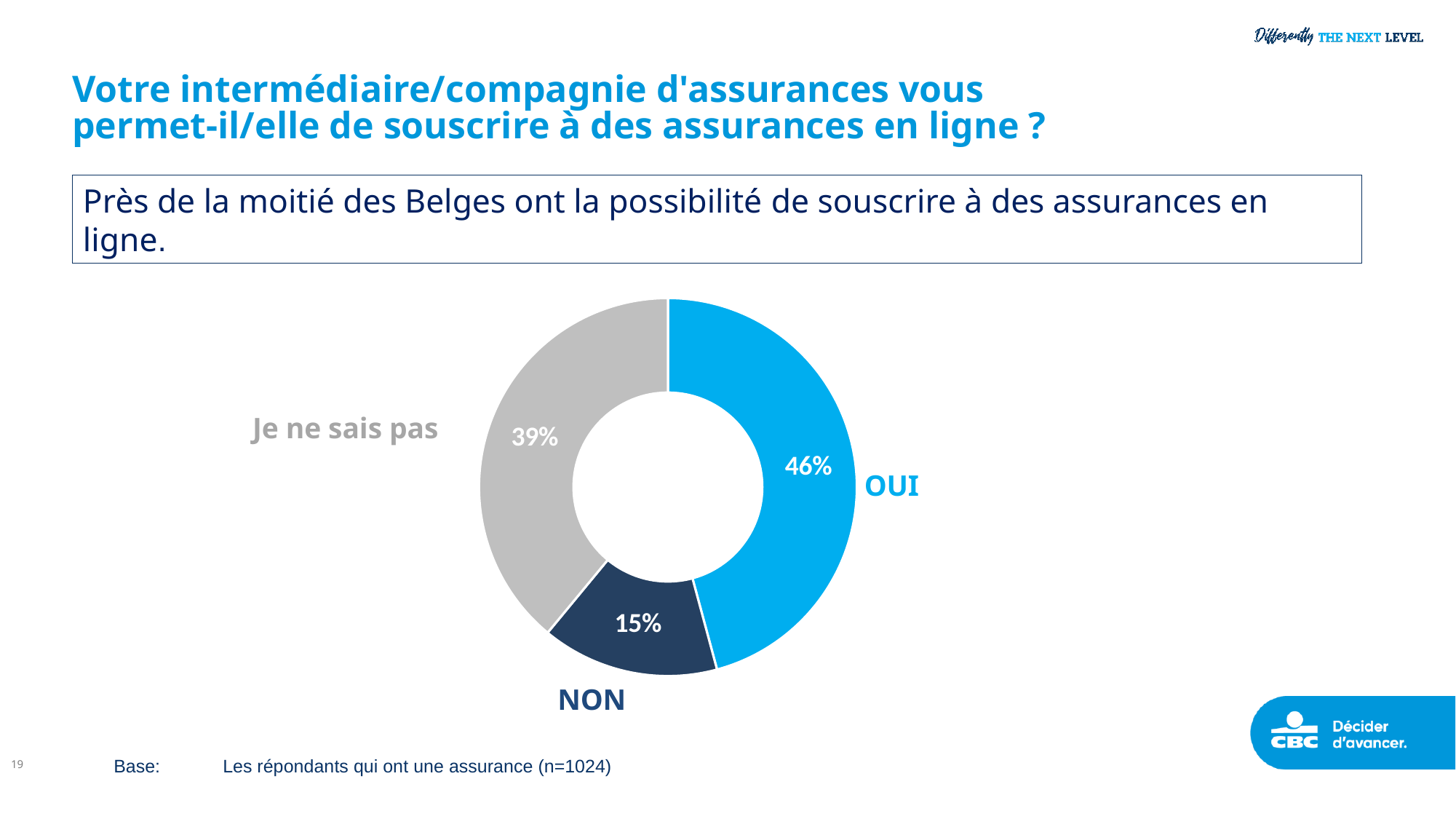
What colour is the OUI slice of the chart? Light blue How many categories are shown in the chart? 3 What kind of chart is shown on the slide? Doughnut chart What is the difference in percentage points between OUI and NON? 31 What percentage of respondents answered Je ne sais pas? 39% What is the base (n) of respondents stated on the slide? n=1024 Which is larger, the share for Je ne sais pas or the share for NON? Je ne sais pas What percentage of respondents answered NON? 15% What percentage of respondents answered OUI? 46% What is the difference in percentage points between OUI and Je ne sais pas? 7 Which response has the smallest share of the chart? NON Which response has the largest share of the chart? OUI